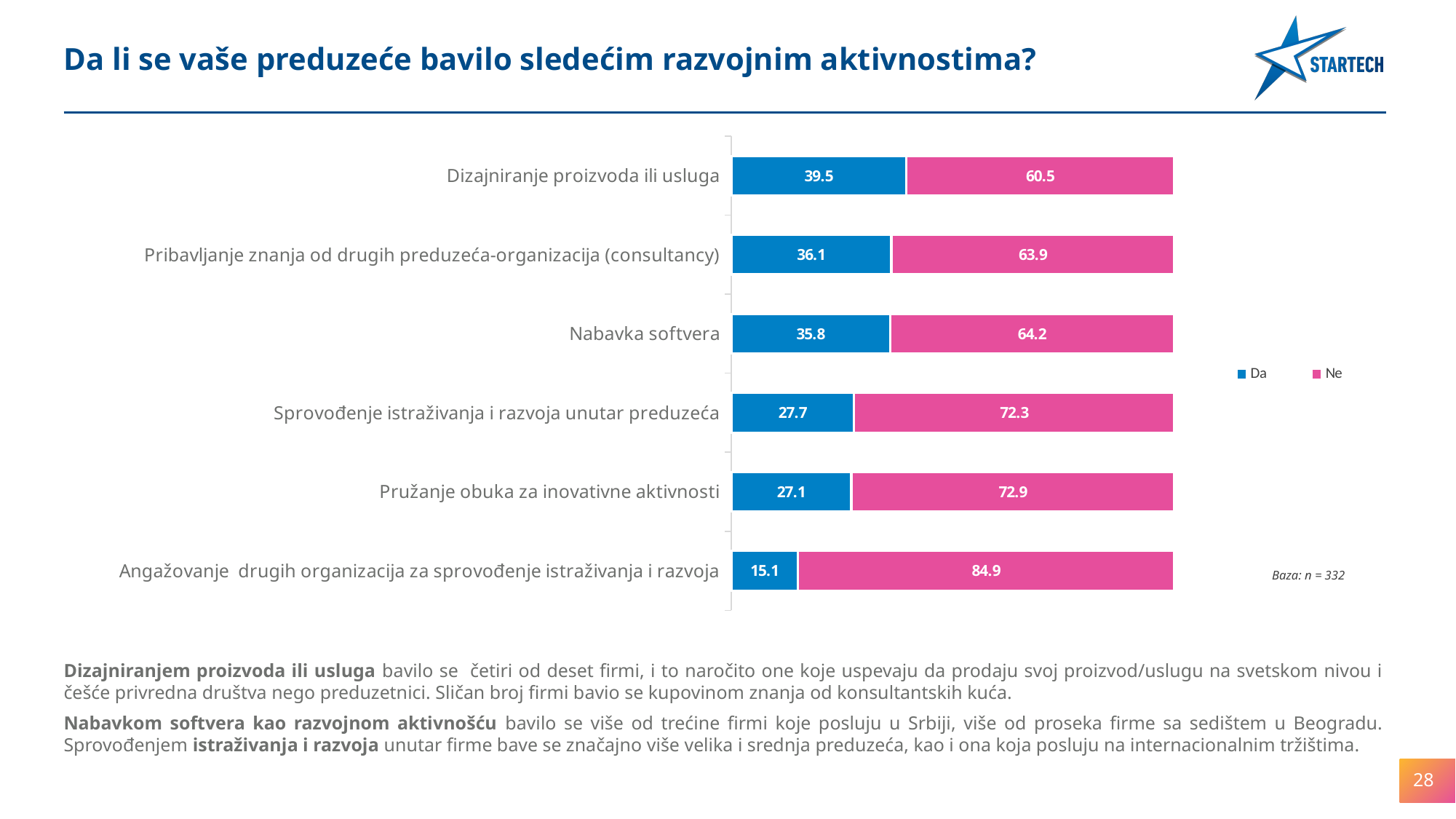
Which category has the lowest "Da" value? Angažovanje drugih organizacija za sprovođenje istraživanja i razvoja What are the two legend entries in the chart? Da and Ne What is the "Da" value for Angažovanje drugih organizacija za sprovođenje istraživanja i razvoja? 15.1 Which category has the highest "Da" value? Dizajniranje proizvoda ili usluga What is the "Da" value for Dizajniranje proizvoda ili usluga? 39.5 What is the total of the stacked bar for Pružanje obuka za inovativne aktivnosti? 100 How many categories are shown in the chart? 6 What is the "Ne" value for Nabavka softvera? 64.2 What kind of chart is shown on the slide? Stacked bar chart Which is larger: the "Da" value for Pribavljanje znanja od drugih preduzeća-organizacija (consultancy) or the "Da" value for Pružanje obuka za inovativne aktivnosti? Pribavljanje znanja od drugih preduzeća-organizacija (consultancy) What is the difference between the "Ne" and "Da" values for Sprovođenje istraživanja i razvoja unutar preduzeća? 44.6 How many series does the legend list? 2